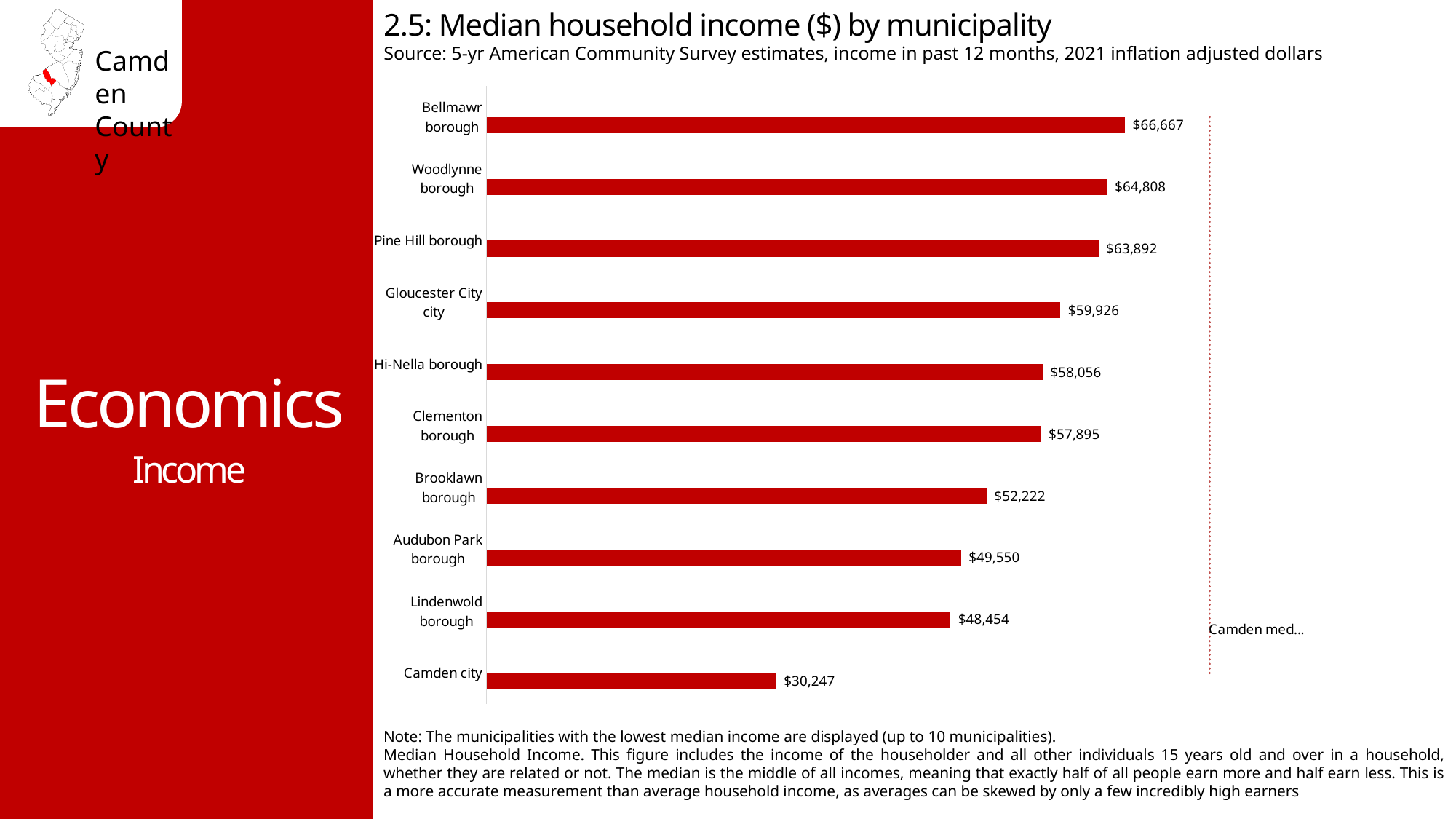
Which has a higher median household income, Gloucester City city or Lindenwold borough? Gloucester City city What is the median household income for Camden city? $30,247 What is the title of the chart? 2.5: Median household income ($) by municipality What is the median household income for Audubon Park borough? $49,550 How many municipalities are shown on the chart? 10 Which municipality has the lowest median household income shown on the chart? Camden city What is the difference in median household income between Brooklawn borough and Audubon Park borough? $2,672 What is the difference in median household income between Bellmawr borough and Camden city? $36,420 Which has a lower median household income, Woodlynne borough or Brooklawn borough? Brooklawn borough What is the median household income for Pine Hill borough? $63,892 What type of chart is used to show median household income by municipality? Bar chart Which municipality has the highest median household income shown on the chart? Bellmawr borough